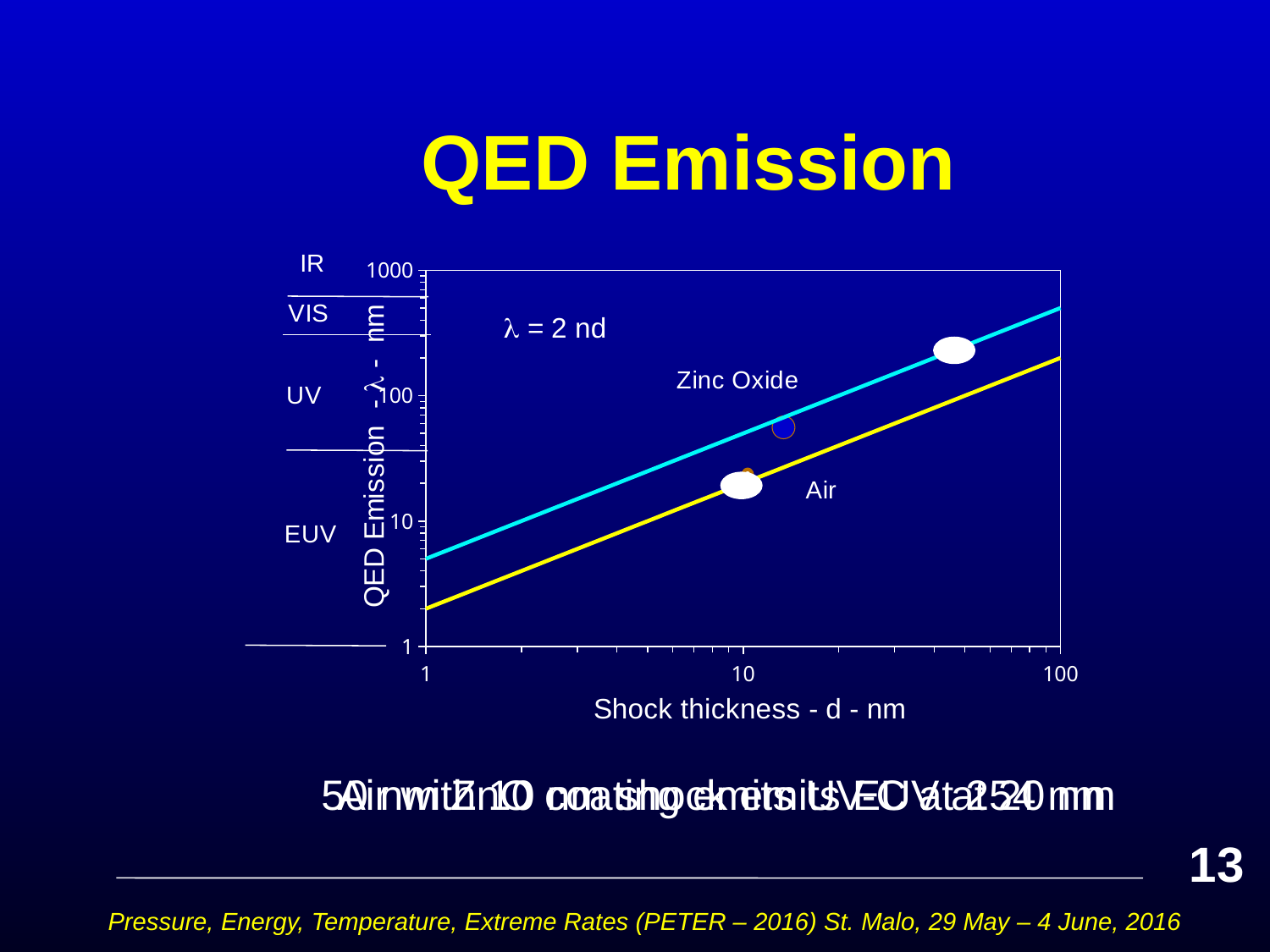
Is the QED Emission for Air at a shock thickness of 100 nm greater or less than 100? greater Which line lies higher on the chart, Zinc Oxide or Air? Zinc Oxide What kind of chart is shown on the slide? line chart What is the highest value shown on the y axis? 1000 Is the QED Emission for Zinc Oxide at a shock thickness of 100 nm greater or less than 100? greater Is the QED Emission for Air at a shock thickness of 10 nm greater or less than 100? less What is the title of the x axis? Shock thickness - d - nm How many lines are plotted on the chart? 2 Does QED Emission rise or fall as shock thickness increases? rise What are the two lines on the chart labelled? Zinc Oxide and Air